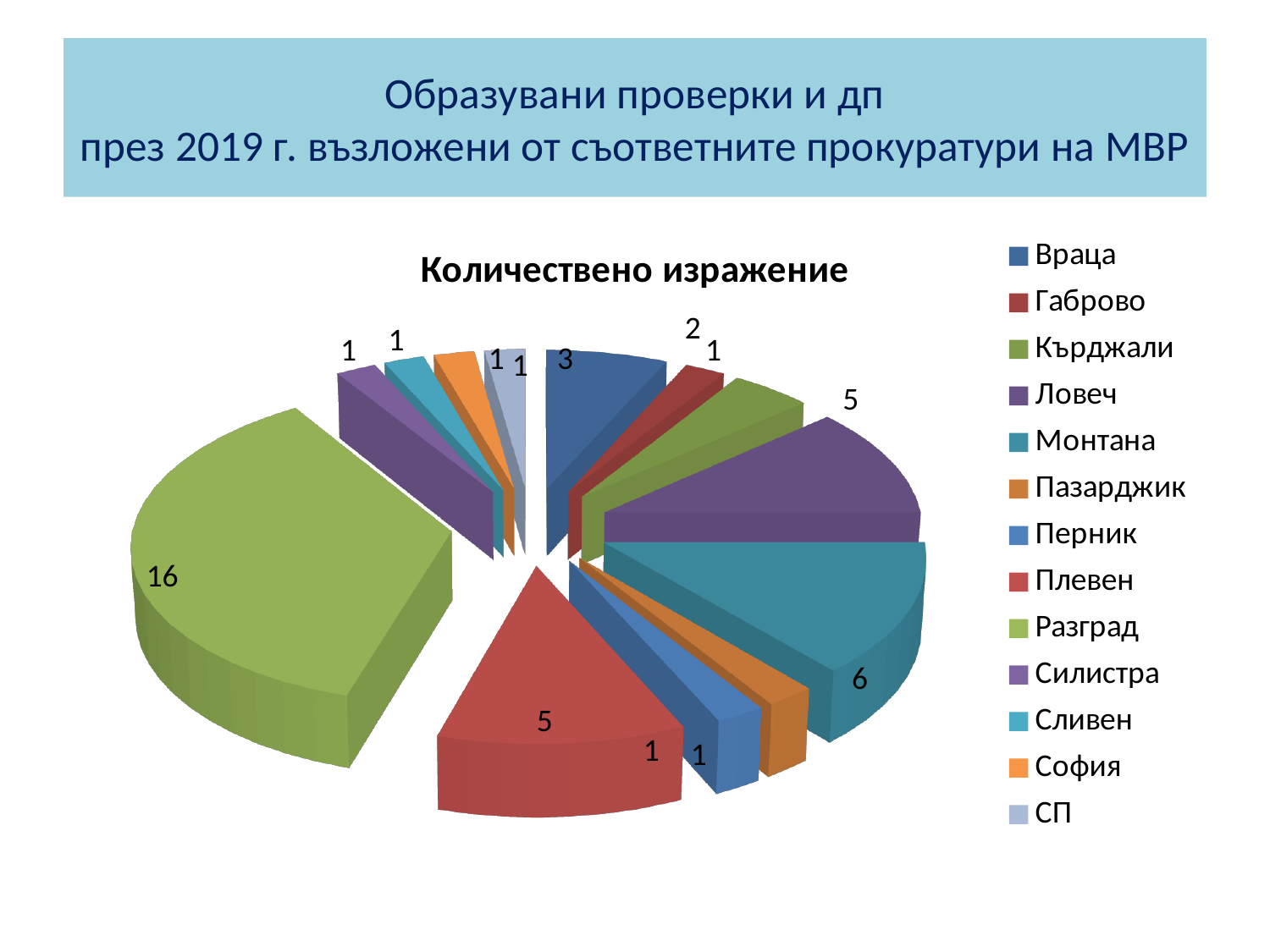
What is the value for Враца? 3 How many categories does the legend list? 13 What is the value for Ловеч? 5 What is the title of the pie chart? Количествено изражение Which category has the largest slice in the pie chart? Разград What is the value for Монтана? 6 Which is larger, the value for Монтана or the value for Плевен? Монтана What is the value for Разград? 16 What is the difference between the values for Разград and Монтана? 10 What kind of chart is shown on the slide? pie chart How many categories have a value of 1? 7 What is the value for Габрово? 1